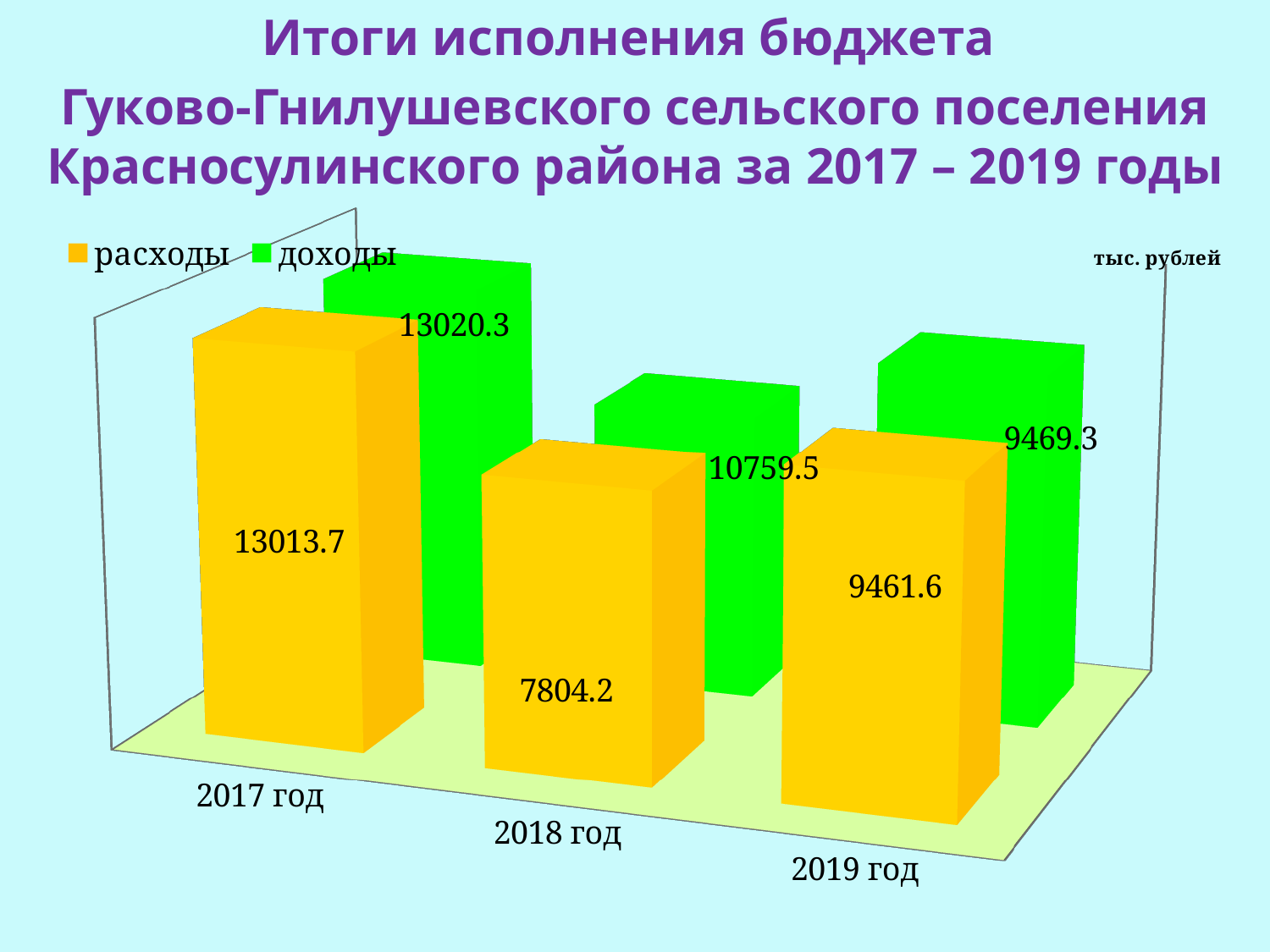
What is the value of расходы for 2019 год? 9461.6 What is the value of расходы for 2017 год? 13013.7 By how much did расходы decrease from 2017 год to 2018 год? 5209.5 Which is larger in 2018 год, доходы or расходы? доходы In which year are доходы the highest? 2017 год What is the value of доходы for 2018 год? 10759.5 Do доходы rise or fall from 2017 год to 2019 год? fall How many series does the legend list? 2 What is the difference between доходы and расходы in 2018 год? 2955.3 How many years are shown on the chart? 3 What is the value of доходы for 2019 год? 9469.3 In which year are расходы the lowest? 2018 год